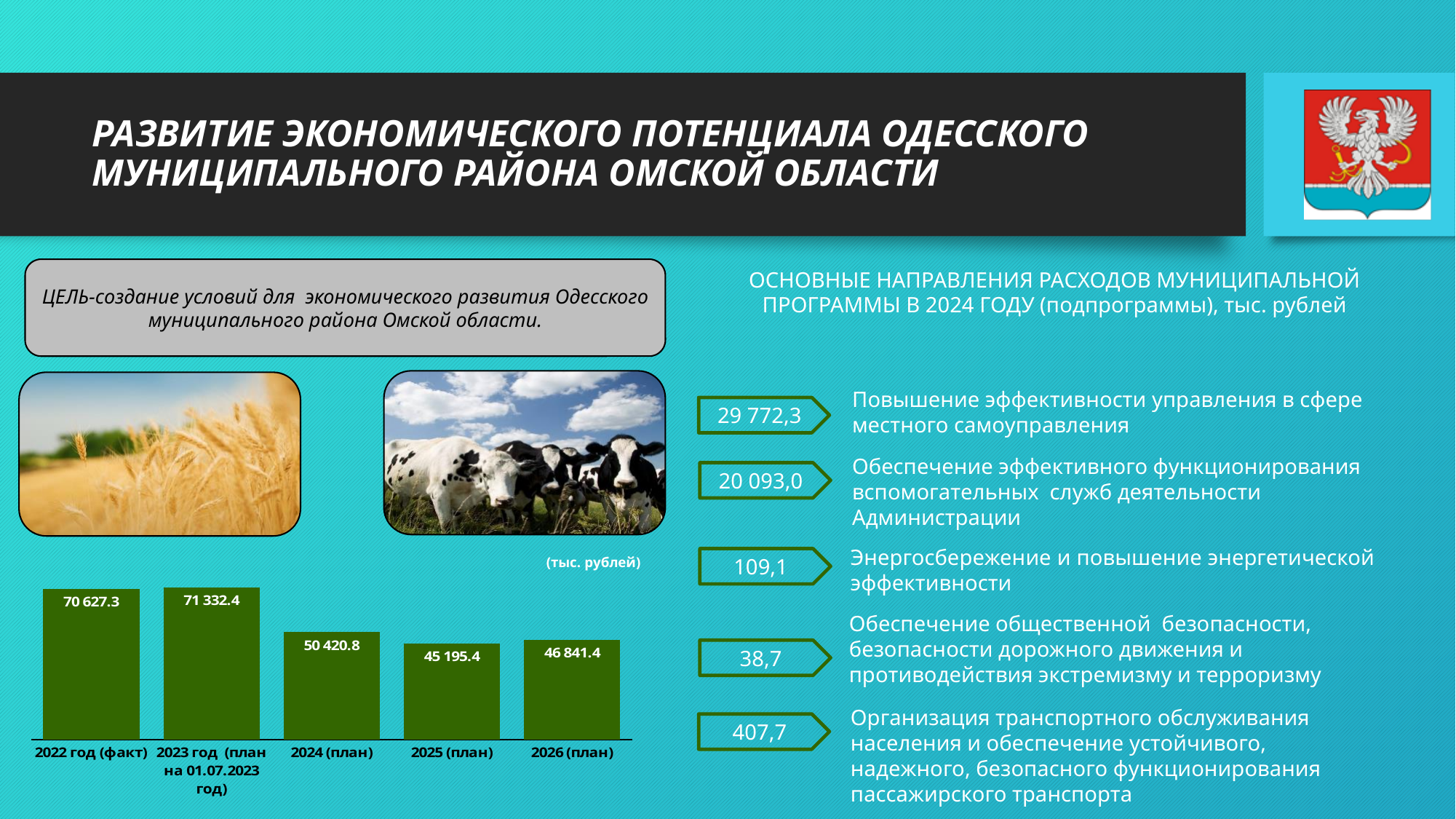
What is the value for 2022 год (факт) in the bar chart? 70 627.3 What is the value for 2024 (план) in the bar chart? 50 420.8 Which category has the lowest value in the bar chart? 2025 (план) What is the difference between the values for 2022 год (факт) and 2024 (план) in the bar chart? 20 206.5 What type of chart is shown on the slide? Bar chart What is the value for 2026 (план) in the bar chart? 46 841.4 How many bars are shown in the bar chart? 5 Which category has the highest value in the bar chart? 2023 год (план на 01.07.2023 год) What is the difference between the values for 2026 (план) and 2025 (план) in the bar chart? 1 646.0 Which is larger in the bar chart: the value for 2024 (план) or the value for 2026 (план)? 2024 (план) What is the value for 2025 (план) in the bar chart? 45 195.4 In what units are the values of the bar chart given? тыс. рублей